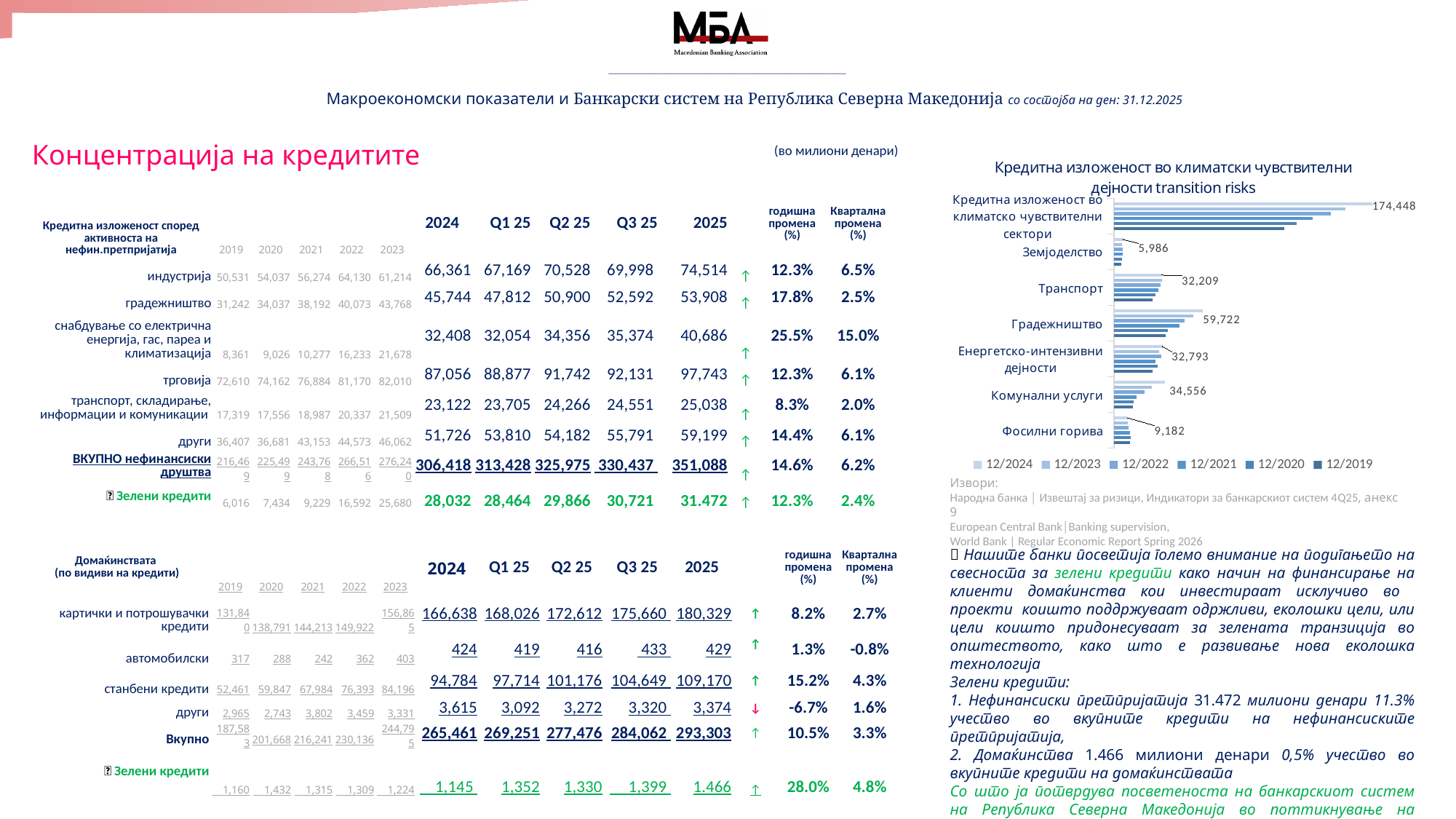
How many series does the legend of the chart 'Кредитна изложеност во климатски чувствителни дејности transition risks' list? 6 In the chart 'Кредитна изложеност во климатски чувствителни дејности transition risks', what is the labelled 12/2024 value for the total 'Кредитна изложеност во климатско чувствителни сектори'? 174,448 In the chart 'Кредитна изложеност во климатски чувствителни дејности transition risks', which has the larger labelled 12/2024 value, Комунални услуги or Фосилни горива? Комунални услуги In the chart 'Кредитна изложеност во климатски чувствителни дејности transition risks', what is the labelled 12/2024 value for Фосилни горива? 9,182 In the chart 'Кредитна изложеност во климатски чувствителни дејности transition risks', what is the difference between the labelled 12/2024 values for Градежништво and Транспорт? 27,513 In the chart 'Кредитна изложеност во климатски чувствителни дејности transition risks', which individual sector (excluding the total) has the highest labelled 12/2024 value? Градежништво In the chart 'Кредитна изложеност во климатски чувствителни дејности transition risks', which sector has the lowest labelled 12/2024 value? Земјоделство What type of chart is shown on the right side of the slide? bar chart In the chart 'Кредитна изложеност во климатски чувствителни дејности transition risks', what is the labelled 12/2024 value for Транспорт? 32,209 In the chart 'Кредитна изложеност во климатски чувствителни дејности transition risks', what is the labelled 12/2024 value for Градежништво? 59,722 In the chart 'Кредитна изложеност во климатски чувствителни дејности transition risks', what is the labelled 12/2024 value for Земјоделство? 5,986 How many categories are shown on the vertical axis of the chart 'Кредитна изложеност во климатски чувствителни дејности transition risks'? 7